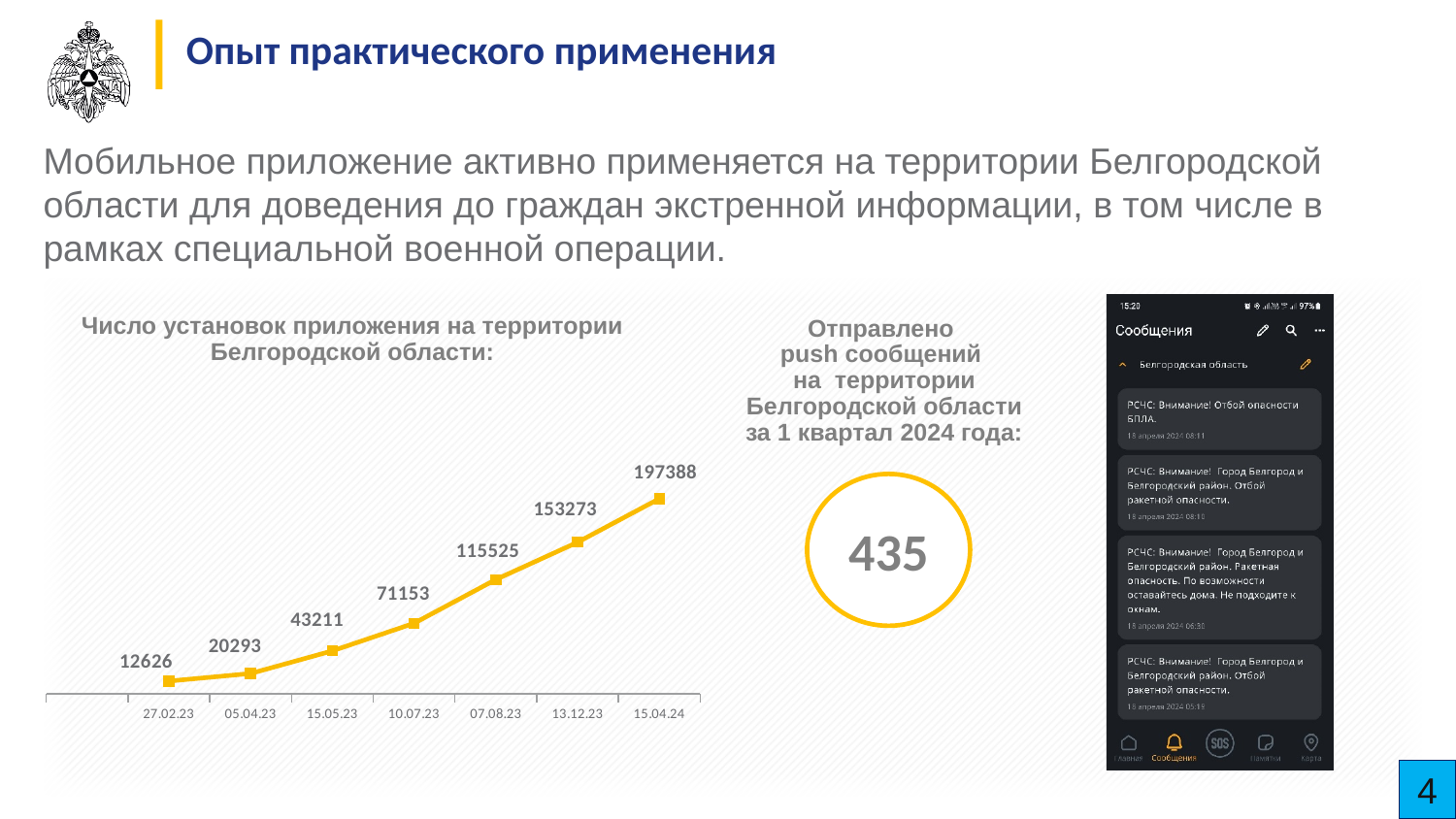
Which date has the lowest number of app installations? 27.02.23 What type of chart is shown on the slide? line chart Do the values rise or fall along the x axis from 27.02.23 to 15.04.24? rise How many data points are plotted on the line chart? 7 Which date has the highest number of app installations? 15.04.24 What is the number of app installations on 15.04.24? 197388 What is the number of app installations on 27.02.23? 12626 Which is larger: the installations on 13.12.23 or on 07.08.23? 13.12.23 What is the difference between the installations on 15.04.24 and 13.12.23? 44115 What is the difference between the installations on 15.05.23 and 05.04.23? 22918 What is the number of app installations on 07.08.23? 115525 What is the number of app installations on 10.07.23? 71153